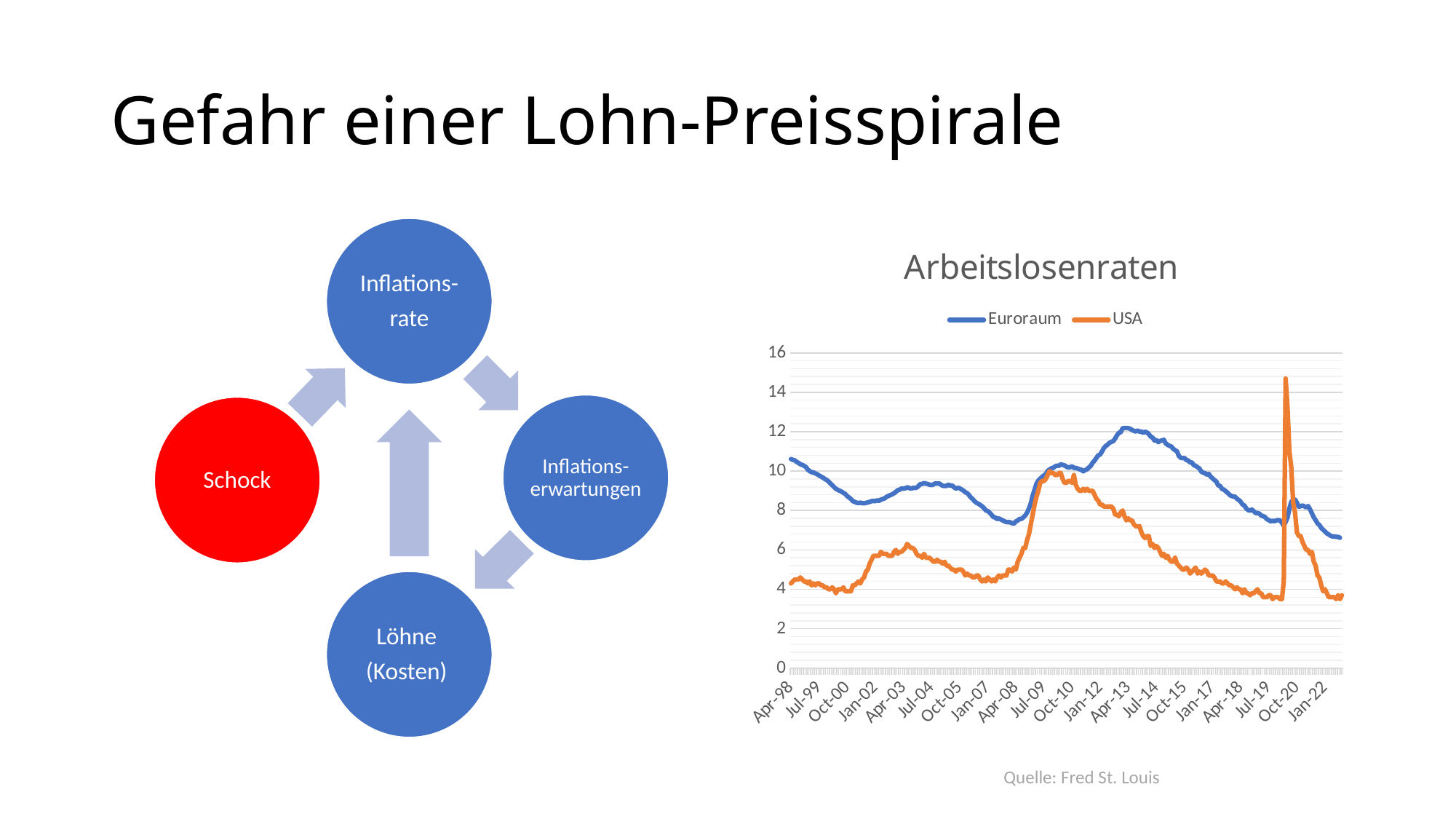
Is the value for Euroraum at Jan-22 greater or less than 8? less Is the highest value of the Euroraum series greater or less than 14? less Is the highest value of the USA series greater or less than 14? greater How many series does the legend of the chart list? 2 What is the title of the chart? Arbeitslosenraten Which two series are listed in the chart's legend? Euroraum and USA Around Apr-13, which series has the higher value, Euroraum or USA? Euroraum Does the Euroraum series rise or fall between Apr-13 and Jul-19? fall Which series reaches the highest peak in the chart? USA What kind of chart is shown on the slide? line chart